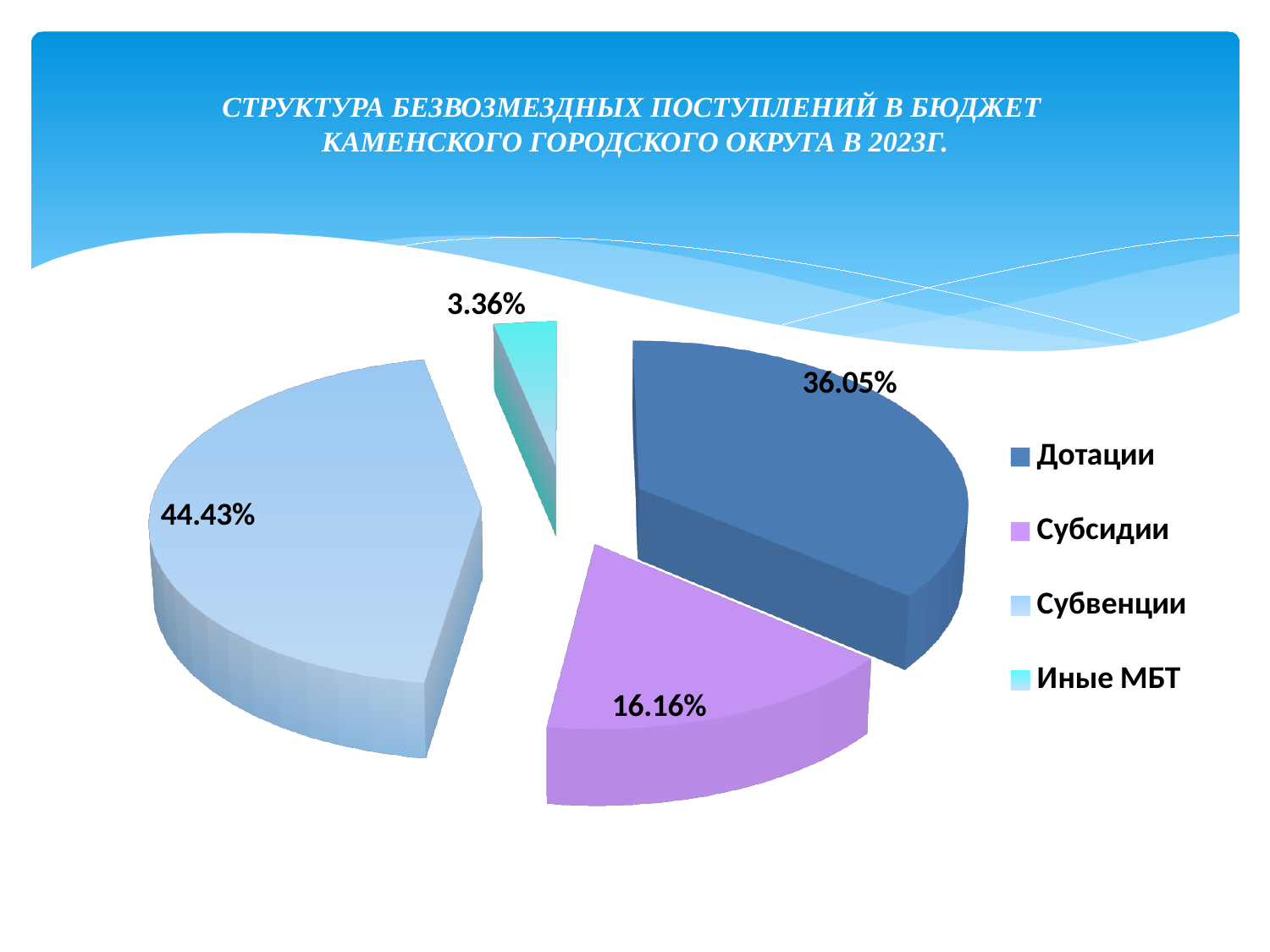
What share of the pie does Иные МБТ have? 3.36% What is the combined share of Субсидии and Иные МБТ? 19.52% Which is larger, the share for Дотации or the share for Субсидии? Дотации Which colour represents Субсидии in the legend? Purple What share of the pie does Субвенции have? 44.43% What share of the pie does Субсидии have? 16.16% What is the difference in percentage points between Субвенции and Дотации? 8.38 What share of the pie does Дотации have? 36.05% Which category has the smallest share of the pie? Иные МБТ How many categories does the pie chart show? 4 Which category has the largest share of the pie? Субвенции What kind of chart is shown on the slide? Pie chart